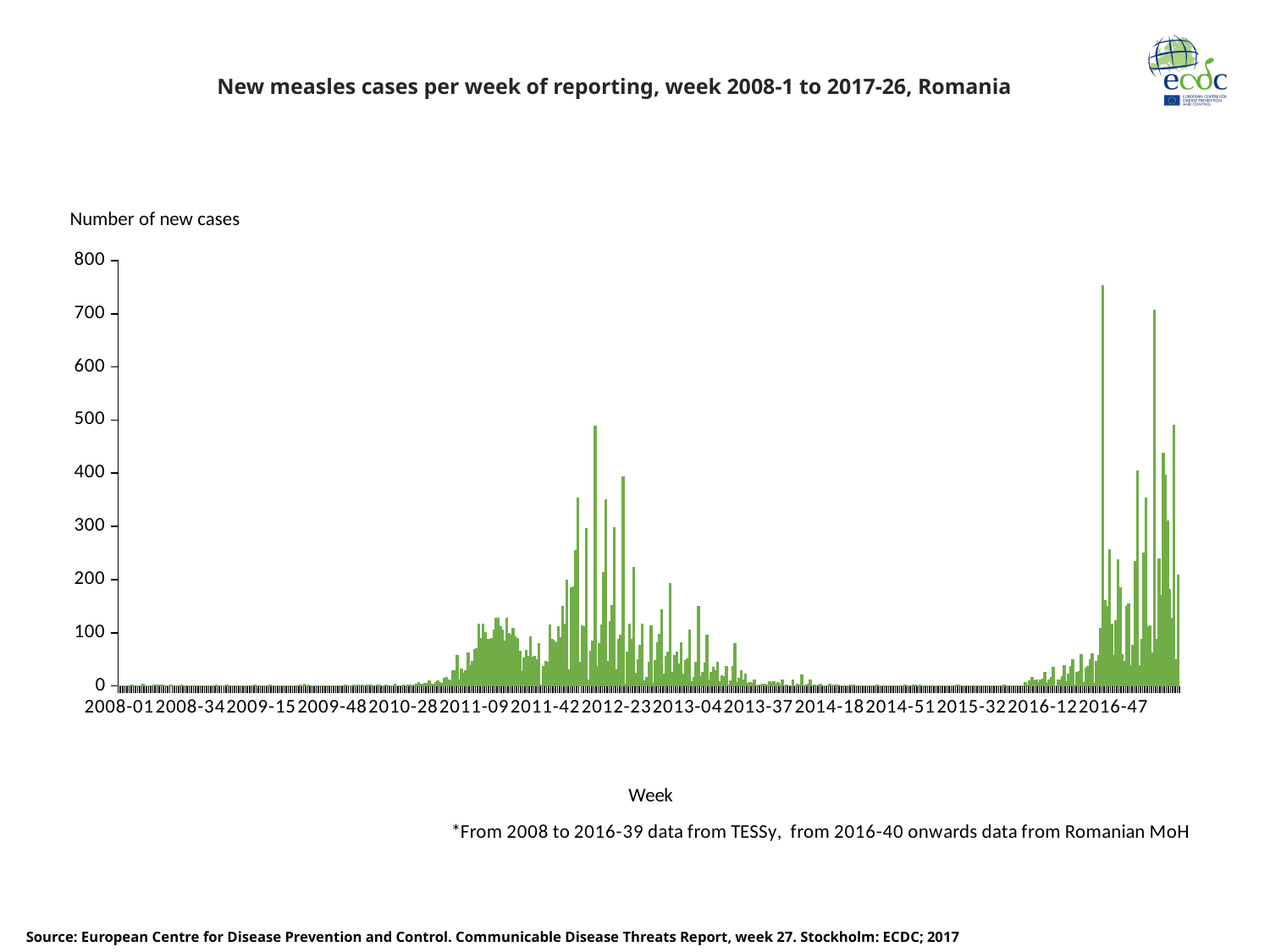
Is the number of new cases around week 2014-18 greater or less than 100? less Is the number of new cases around week 2008-34 greater or less than 100? less How many week labels are printed along the horizontal axis? 15 Is the highest bar in the 2012 outbreak period greater or less than 400? greater What is the title of the chart? New measles cases per week of reporting, week 2008-1 to 2017-26, Romania Which period has the higher peak of weekly cases: the 2011-2012 outbreak or the 2016-2017 outbreak? 2016-2017 outbreak What is the highest value shown on the vertical axis? 800 What kind of chart is shown on the slide? Bar chart What is the label on the vertical axis of the chart? Number of new cases